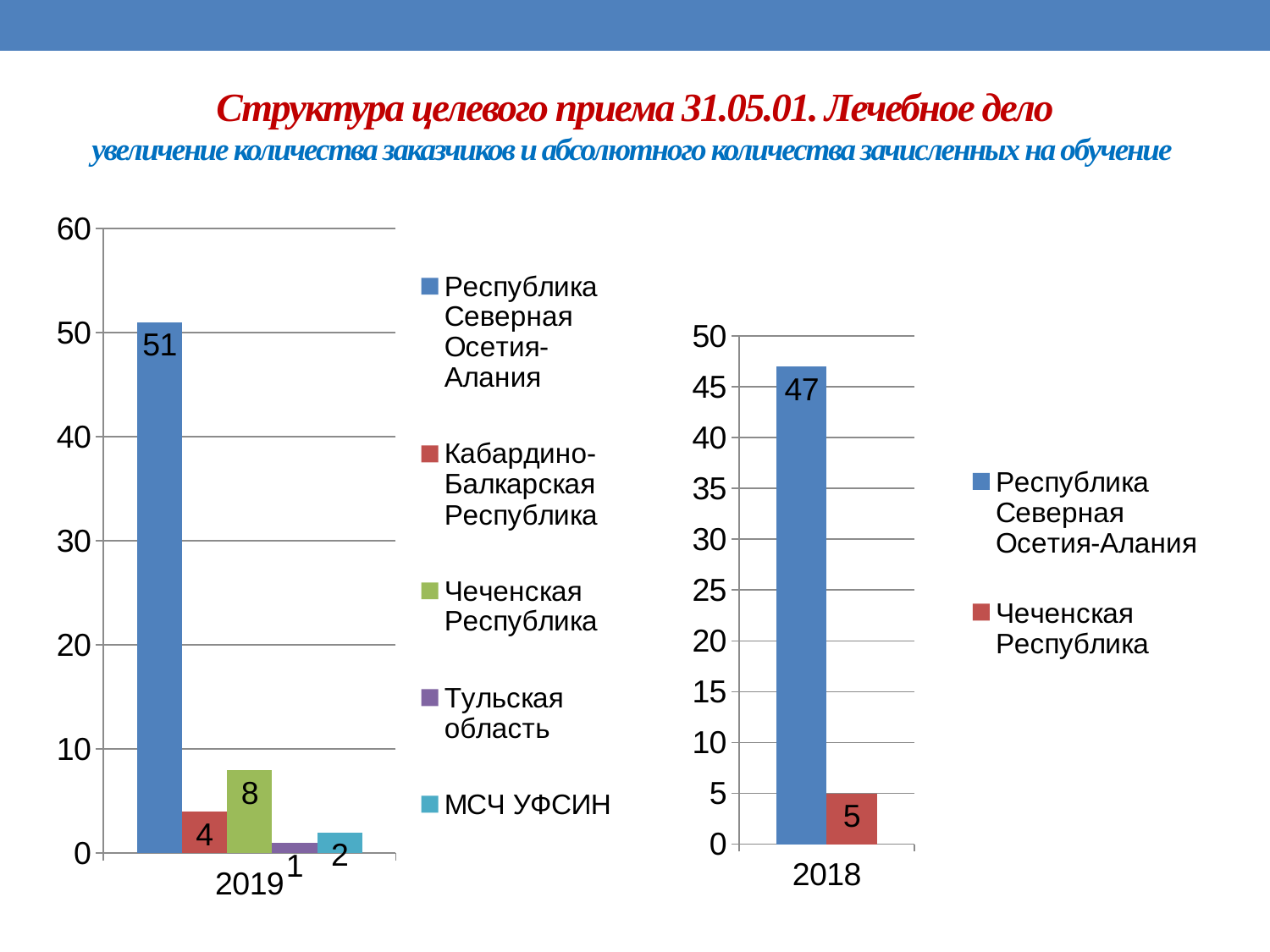
In the left chart (2019), which series has the lowest value? Тульская область In the left chart (2019), which series has the highest value? Республика Северная Осетия-Алания In the left chart (2019), what is the difference between the values for Республика Северная Осетия-Алания and Чеченская Республика? 43 In the left chart (2019), what is the value for Республика Северная Осетия-Алания? 51 In the left chart (2019), what is the value for Кабардино-Балкарская Республика? 4 What kind of chart is the right chart (2018)? bar chart In the left chart (2019), what is the value for Чеченская Республика? 8 How many series does the legend of the right chart (2018) list? 2 In the right chart (2018), what is the difference between the values for Республика Северная Осетия-Алания and Чеченская Республика? 42 In the right chart (2018), what is the value for Республика Северная Осетия-Алания? 47 In the right chart (2018), what is the value for Чеченская Республика? 5 How many series does the legend of the left chart (2019) list? 5